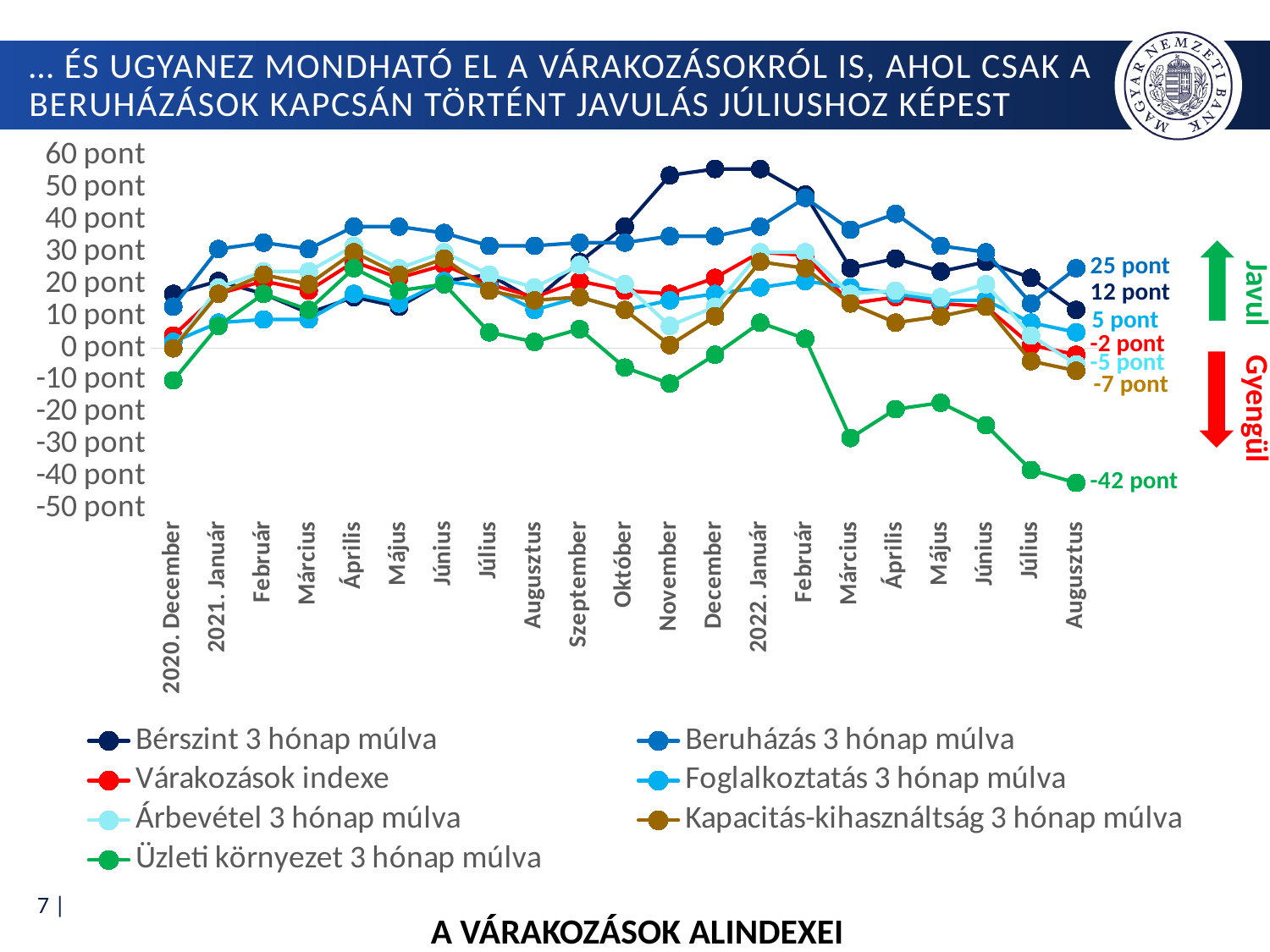
Which series has the lowest value in Augusztus 2022? Üzleti környezet 3 hónap múlva What type of chart is shown on the slide? line chart Is the value of 'Bérszint 3 hónap múlva' in December 2021 greater or less than 50 pont? greater How many months are shown along the x axis? 21 What is the value of 'Üzleti környezet 3 hónap múlva' in Augusztus 2022? -42 pont Which series has the highest value in Augusztus 2022? Beruházás 3 hónap múlva Does 'Üzleti környezet 3 hónap múlva' rise or fall from Február 2022 to Augusztus 2022? fall What is the value of 'Beruházás 3 hónap múlva' in Augusztus 2022? 25 pont How many series does the legend list? 7 What is the value of 'Kapacitás-kihasználtság 3 hónap múlva' in Augusztus 2022? -7 pont What is the difference between the Augusztus 2022 values of 'Beruházás 3 hónap múlva' and 'Bérszint 3 hónap múlva'? 13 pont What is the value of 'Bérszint 3 hónap múlva' in Augusztus 2022? 12 pont